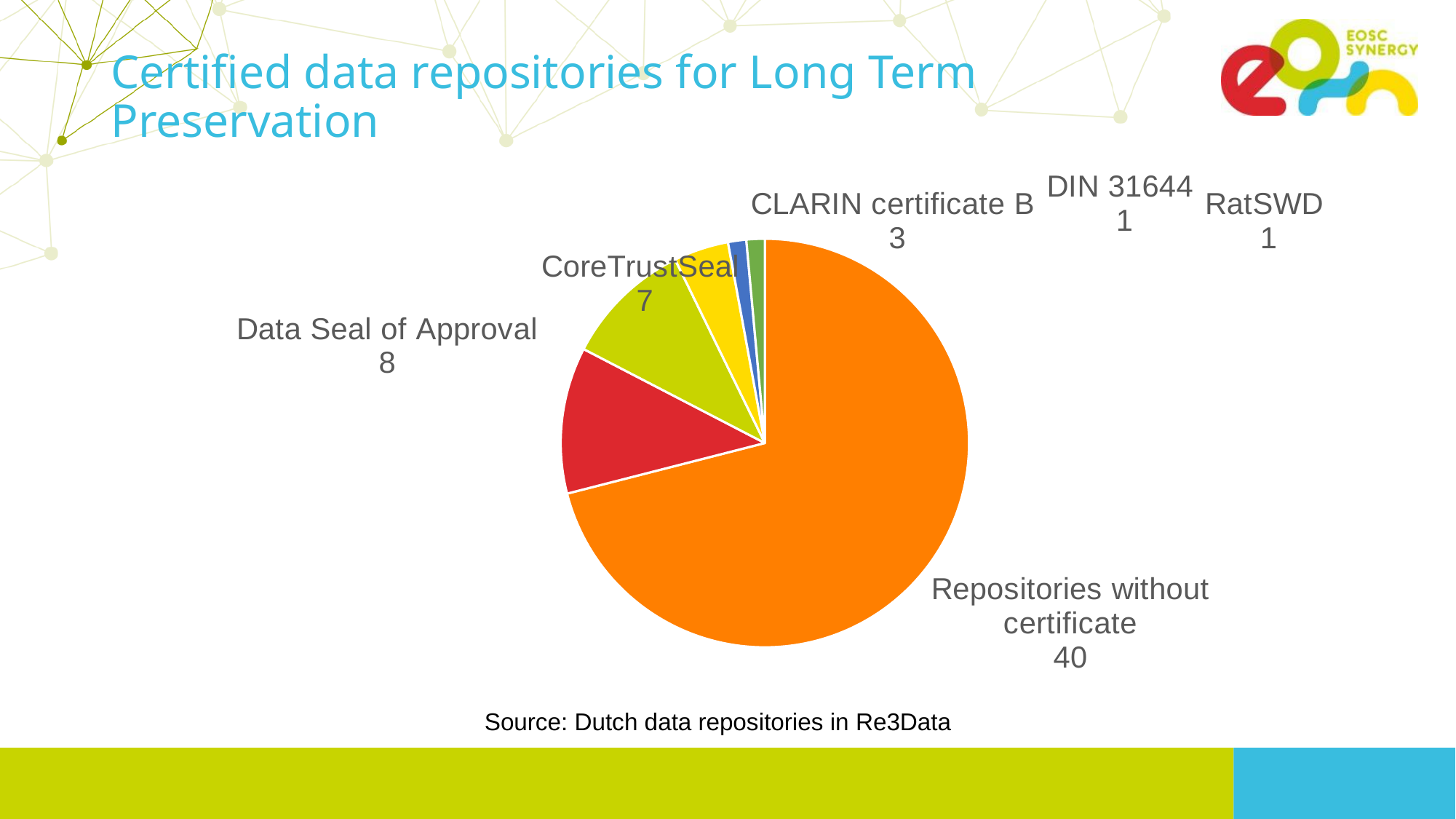
What is the value for CLARIN certificate B? 3 How many slices does the pie chart have? 6 What is the value for CoreTrustSeal? 7 What is the total of all the values shown in the pie chart? 60 What is the value for Repositories without certificate? 40 Which categories have the smallest value in the pie chart? DIN 31644 and RatSWD Which is larger, Data Seal of Approval or CoreTrustSeal? Data Seal of Approval What kind of chart is shown on the slide? Pie chart What is the value for Data Seal of Approval? 8 Which category has the largest slice of the pie? Repositories without certificate What is the difference between Repositories without certificate and Data Seal of Approval? 32 What is the title of the slide containing the pie chart? Certified data repositories for Long Term Preservation